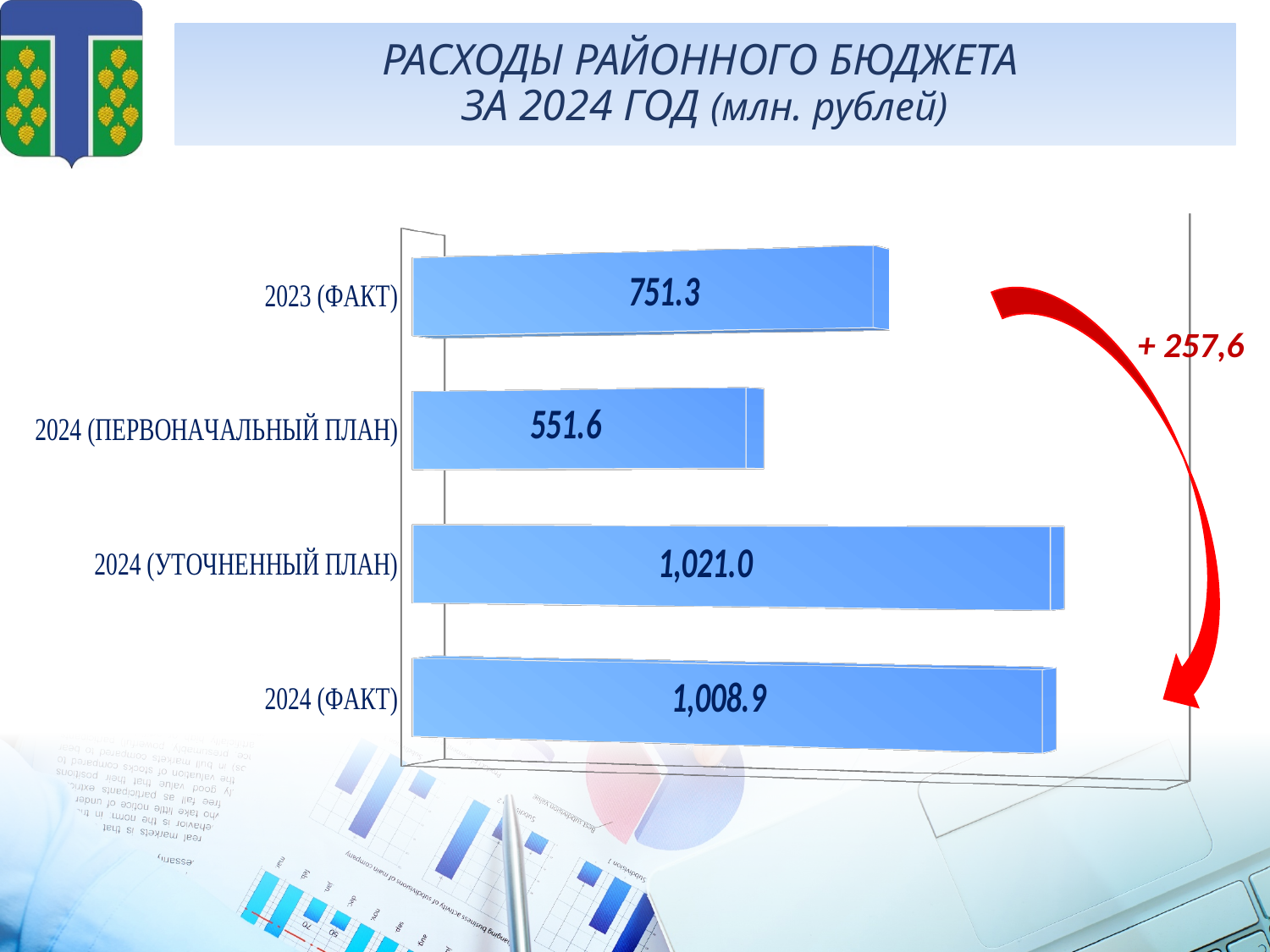
Which category has the lowest value? 2024 (ПЕРВОНАЧАЛЬНЫЙ ПЛАН) Which category has the highest value? 2024 (УТОЧНЕННЫЙ ПЛАН) What is the difference between the values for 2024 (ФАКТ) and 2023 (ФАКТ)? 257.6 Which is larger, the value for 2023 (ФАКТ) or the value for 2024 (ПЕРВОНАЧАЛЬНЫЙ ПЛАН)? 2023 (ФАКТ) What is the value for 2024 (ФАКТ)? 1,008.9 What unit is given in the chart title? млн. рублей What is the value for 2024 (ПЕРВОНАЧАЛЬНЫЙ ПЛАН)? 551.6 What kind of chart is shown on the slide? Bar chart How many categories are shown in the chart? 4 What is the difference between the values for 2024 (УТОЧНЕННЫЙ ПЛАН) and 2024 (ФАКТ)? 12.1 What is the value for 2024 (УТОЧНЕННЫЙ ПЛАН)? 1,021.0 What is the value for 2023 (ФАКТ)? 751.3